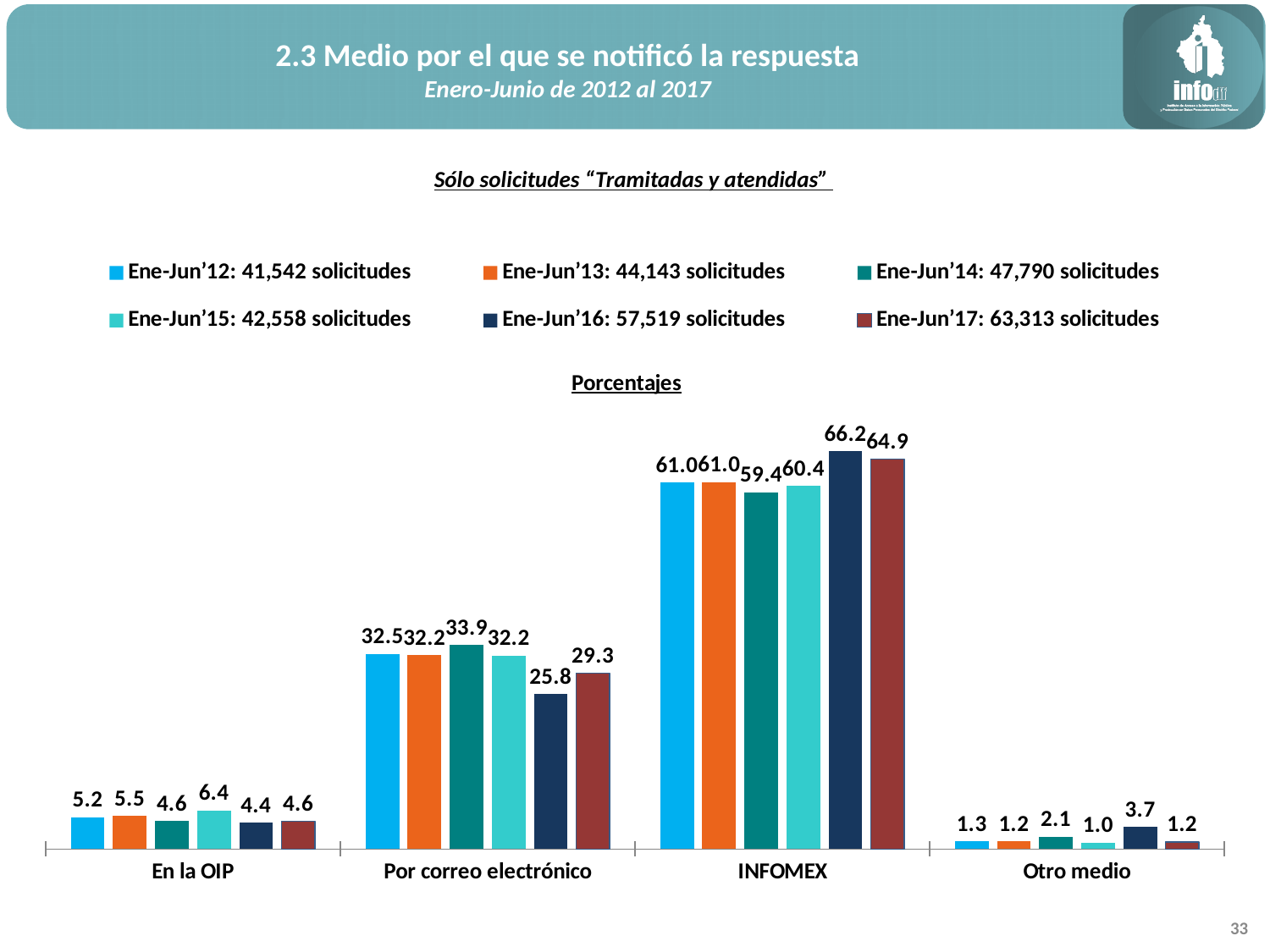
What is the difference between the Ene-Jun'16 and Ene-Jun'17 values for INFOMEX? 1.3 What percentage is shown for Por correo electrónico in the Ene-Jun'17 series? 29.3 What percentage is shown for INFOMEX in the Ene-Jun'16 series? 66.2 What percentage is shown for Otro medio in the Ene-Jun'16 series? 3.7 What kind of chart is shown on the slide? Bar chart What percentage is shown for En la OIP in the Ene-Jun'15 series? 6.4 How many series does the legend list? 6 Which series has the highest value for INFOMEX? Ene-Jun'16 Which is larger for En la OIP: the Ene-Jun'13 value or the Ene-Jun'16 value? Ene-Jun'13 How many categories are shown on the x axis of the chart? 4 Which series has the lowest value for Por correo electrónico? Ene-Jun'16 What is the difference between the Ene-Jun'14 and Ene-Jun'16 values for Por correo electrónico? 8.1